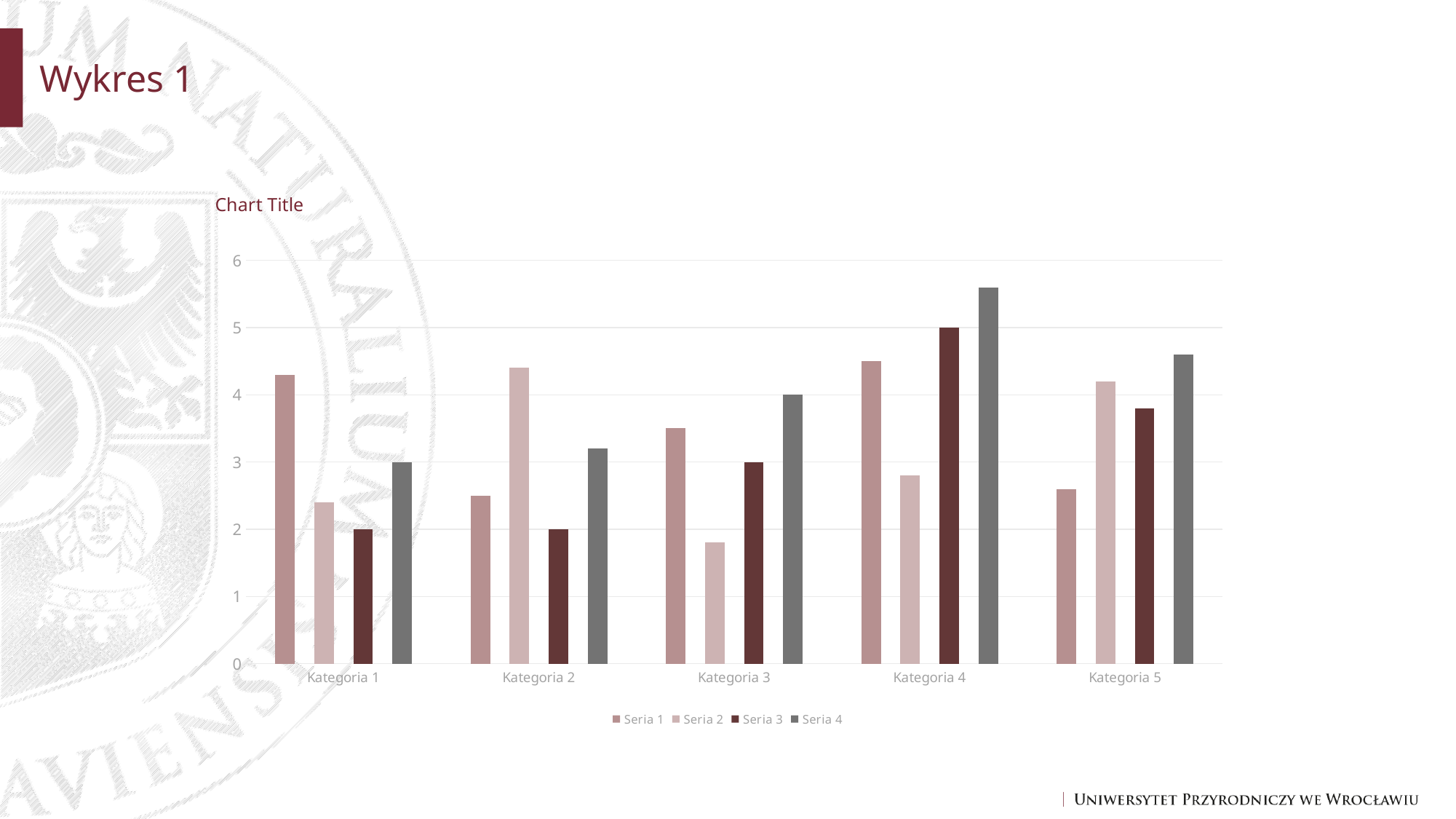
What is the value of Seria 4 for Kategoria 3? 4 Which series has the highest value in Kategoria 4? Seria 4 Which series has the lowest value in Kategoria 3? Seria 2 What is the value of Seria 3 for Kategoria 4? 5 How many series does the legend list? 4 In Kategoria 2, which is larger: Seria 1 or Seria 2? Seria 2 What is the value of Seria 3 for Kategoria 1? 2 What kind of chart is shown on the slide? bar chart Is the value of Seria 2 for Kategoria 3 greater or less than 2? less What is the difference between the Seria 3 values for Kategoria 4 and Kategoria 1? 3 Is the value of Seria 4 for Kategoria 4 greater or less than 5? greater How many categories are shown on the x axis? 5